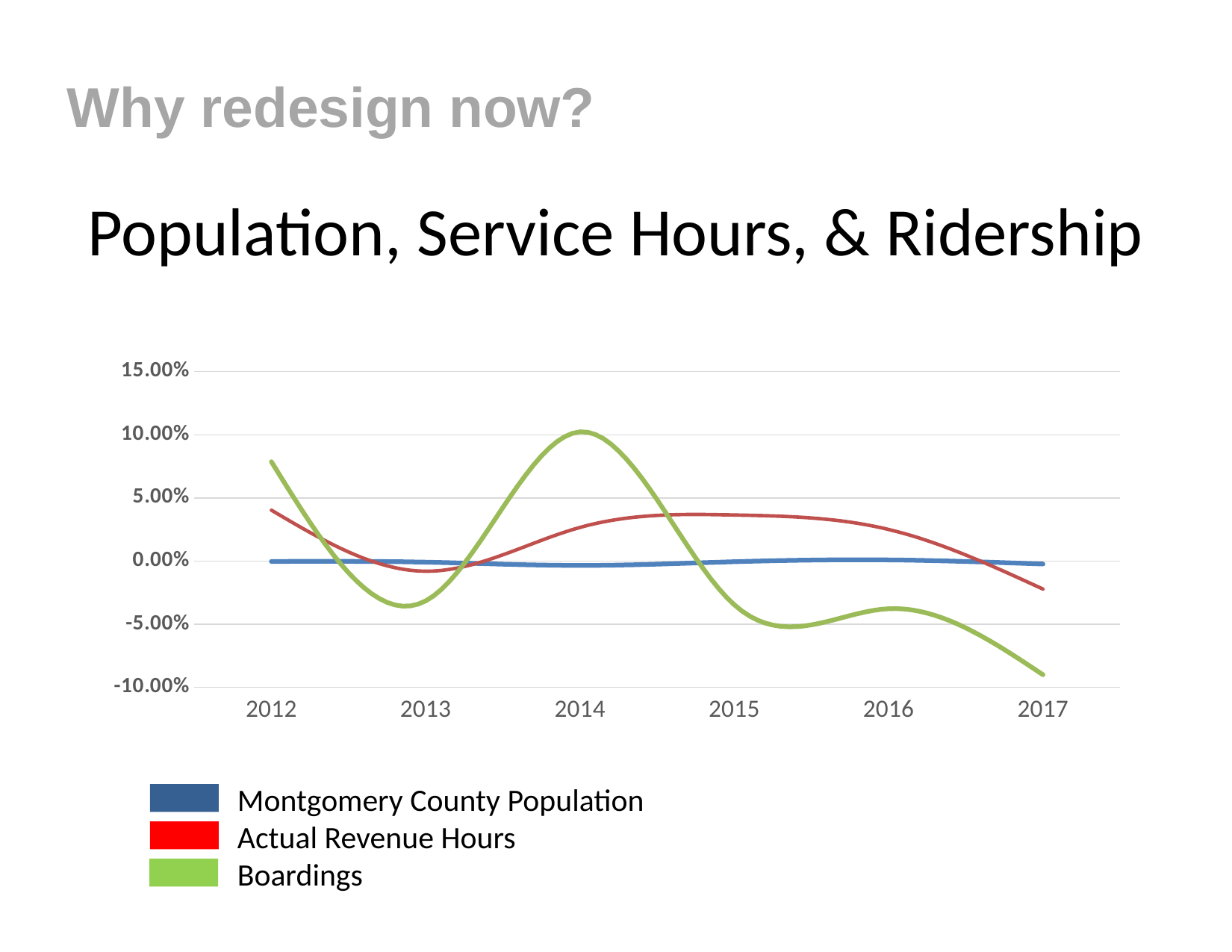
Is the Actual Revenue Hours value for 2017 greater or less than 0.00%? less How many series does the legend list? 3 Which series is shown in green in the legend? Boardings What kind of chart is shown on the slide? line chart In which year is the Boardings value lowest? 2017 In which year is the Boardings value highest? 2014 In 2014, which is larger: Boardings or Actual Revenue Hours? Boardings Is the Boardings value for 2012 greater or less than 5.00%? greater Does the Boardings line rise or fall from 2014 to 2017? fall How many years are shown on the x axis? 6 Is the Boardings value for 2017 greater or less than -5.00%? less In 2017, which is larger: Actual Revenue Hours or Boardings? Actual Revenue Hours